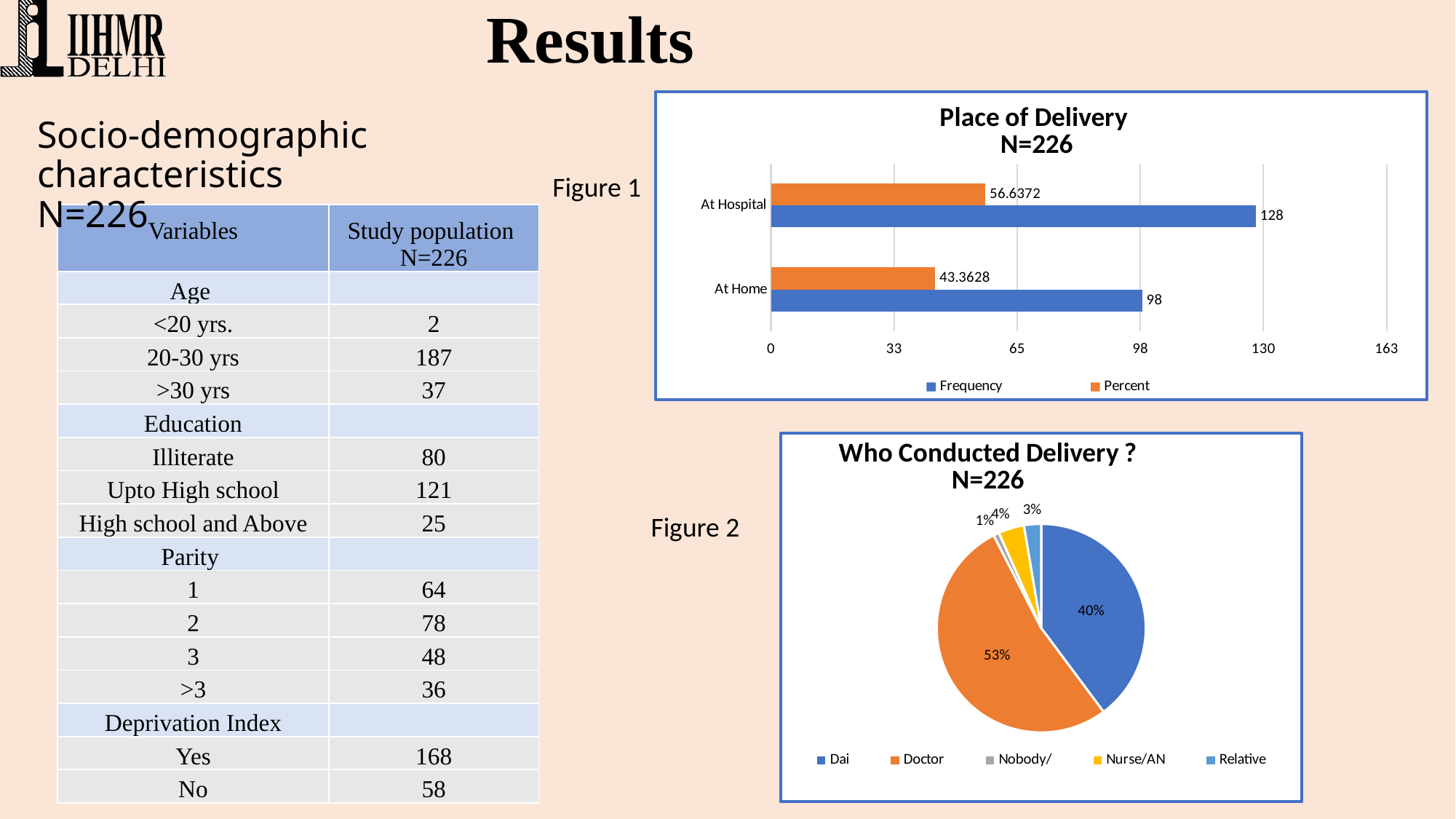
In the 'Who Conducted Delivery ?' chart, what share of the pie is Doctor? 53% In the 'Place of Delivery' chart, what is the Frequency value for At Home? 98 In the 'Place of Delivery' chart, which category has the higher Frequency? At Hospital In the 'Place of Delivery' chart, what is the Frequency value for At Hospital? 128 How many categories does the legend of the 'Who Conducted Delivery ?' chart list? 5 What kind of chart is the 'Place of Delivery' chart? Bar chart In the 'Place of Delivery' chart, what is the Percent value for At Home? 43.3628 In the 'Who Conducted Delivery ?' chart, which category has the smallest share? Nobody/ In the 'Who Conducted Delivery ?' chart, what share of the pie is Dai? 40% In the 'Place of Delivery' chart, what is the difference between the Frequency values for At Hospital and At Home? 30 How many series does the legend of the 'Place of Delivery' chart list? 2 In the 'Place of Delivery' chart, what is the Percent value for At Hospital? 56.6372